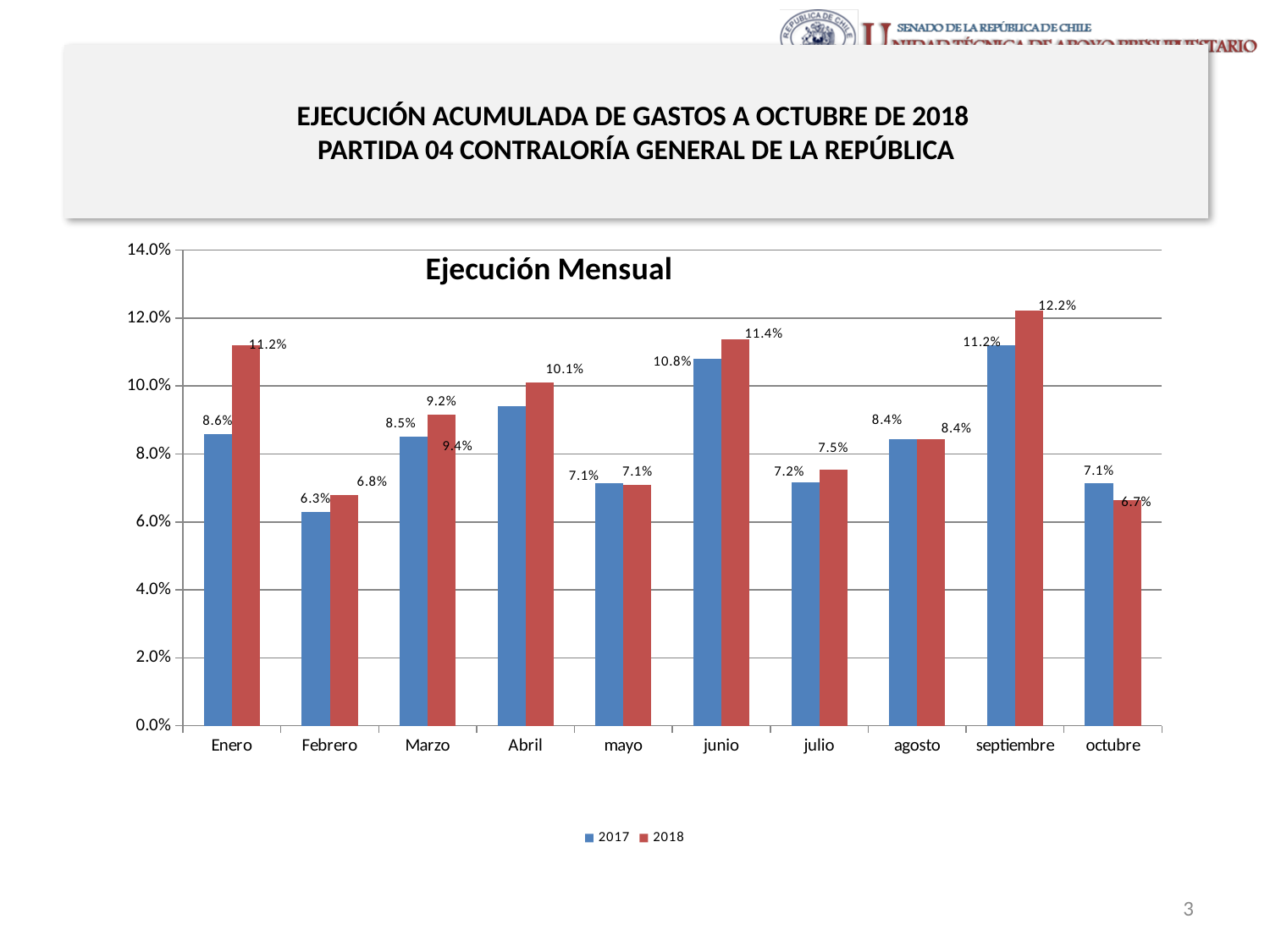
Is the value for 2018 in septiembre greater or less than 12.0%? greater What is the value for 2018 in julio? 7.5% What is the difference between the 2018 and 2017 values in Enero? 2.6% What is the title of the chart? Ejecución Mensual What is the value for 2017 in junio? 10.8% Which is larger in octubre, the 2017 value or the 2018 value? 2017 How many series does the legend list? 2 How many months are shown on the x axis? 10 What is the value for 2018 in Enero? 11.2% Which month has the highest value for 2018? septiembre What type of chart is shown on the slide? bar chart Which month has the lowest value for 2017? Febrero